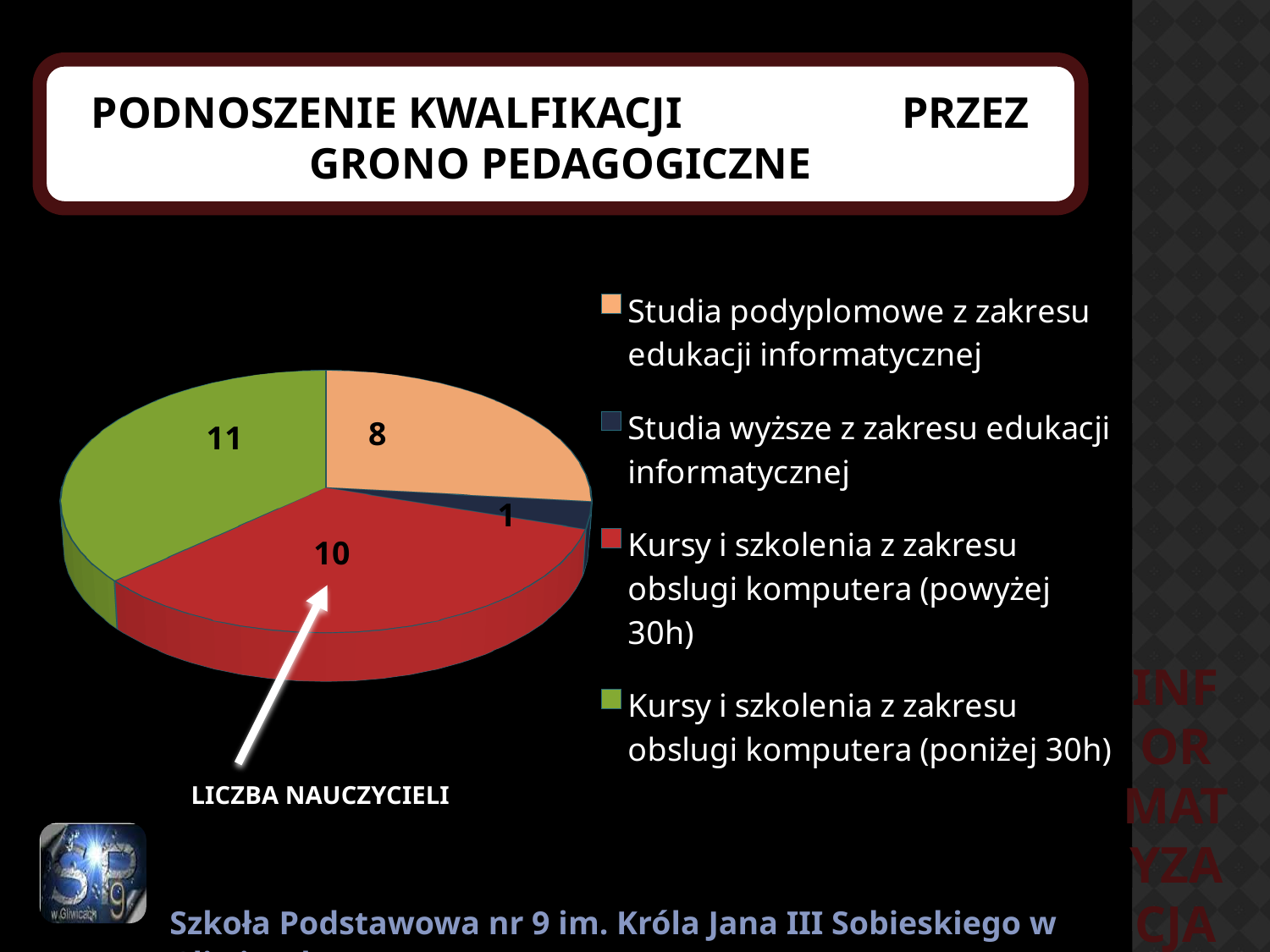
How many entries does the legend list? 4 Which category has the smallest slice of the pie? Studia wyższe z zakresu edukacji informatycznej What is the value for 'Studia podyplomowe z zakresu edukacji informatycznej'? 8 What type of chart is shown on the slide? pie chart Which category has the largest slice of the pie? Kursy i szkolenia z zakresu obslugi komputera (poniżej 30h) Which is larger: the value for 'Studia podyplomowe z zakresu edukacji informatycznej' or for 'Kursy i szkolenia z zakresu obslugi komputera (powyżej 30h)'? Kursy i szkolenia z zakresu obslugi komputera (powyżej 30h) What is the value for 'Studia wyższe z zakresu edukacji informatycznej'? 1 What colour is the slice for 'Kursy i szkolenia z zakresu obslugi komputera (powyżej 30h)'? red What is the value for 'Kursy i szkolenia z zakresu obslugi komputera (powyżej 30h)'? 10 How many slices does the pie chart have? 4 What is the value for 'Kursy i szkolenia z zakresu obslugi komputera (poniżej 30h)'? 11 What is the difference between the value for 'Kursy i szkolenia z zakresu obslugi komputera (poniżej 30h)' and 'Studia podyplomowe z zakresu edukacji informatycznej'? 3